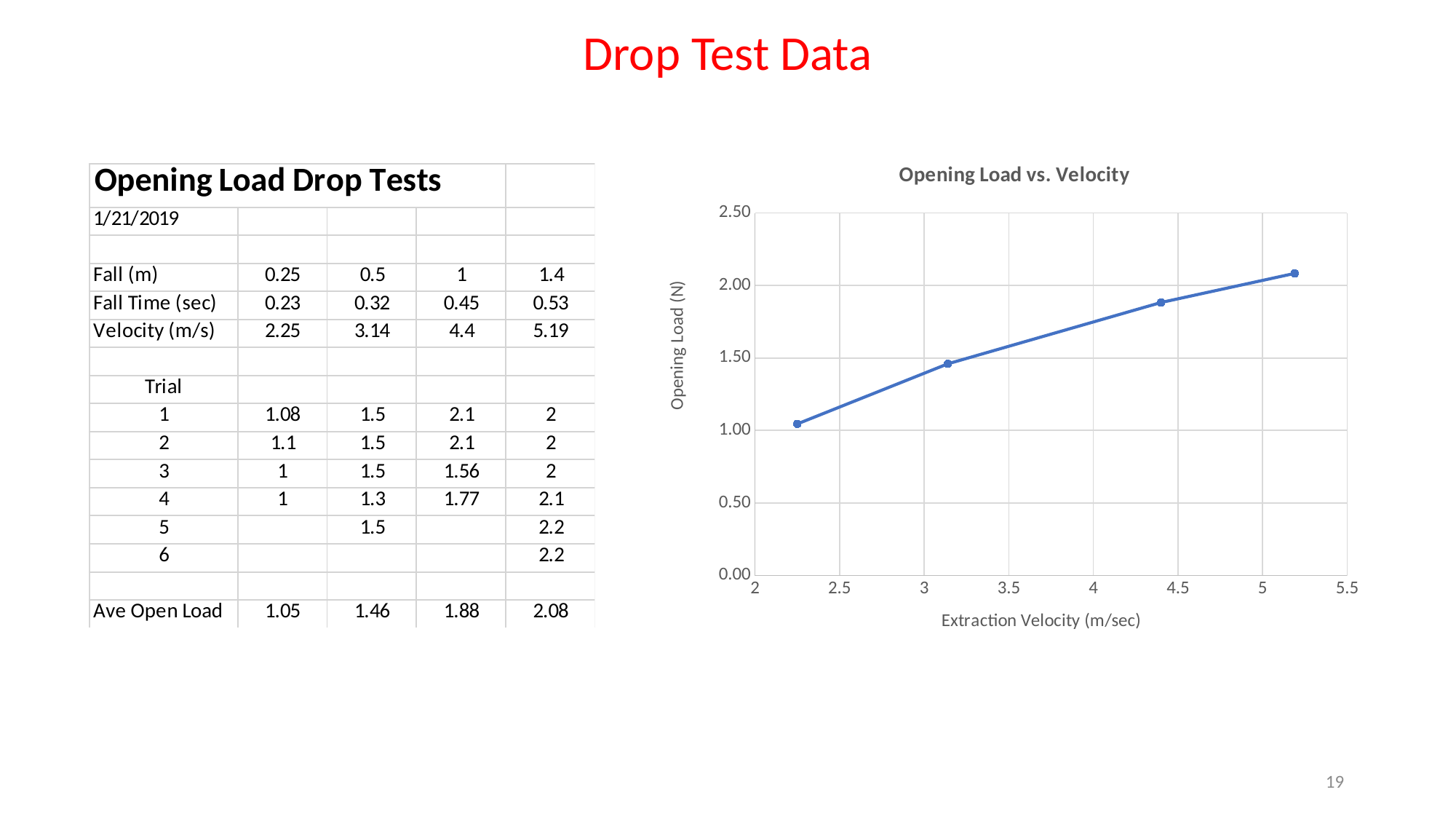
What is the title of the chart on the slide? Opening Load vs. Velocity On the "Opening Load vs. Velocity" chart, is the opening load at the lowest plotted velocity greater or less than 1.50? less What is the label on the vertical axis of the "Opening Load vs. Velocity" chart? Opening Load (N) On the "Opening Load vs. Velocity" chart, is the opening load at the third point from the left greater or less than 1.50? greater On the "Opening Load vs. Velocity" chart, is the opening load at the lowest velocity larger or smaller than at the highest velocity? smaller On the "Opening Load vs. Velocity" chart, does the opening load rise or fall as extraction velocity increases? rises How many data points are plotted on the "Opening Load vs. Velocity" chart? 4 What kind of chart is "Opening Load vs. Velocity"? line chart On the "Opening Load vs. Velocity" chart, is the opening load at the highest plotted velocity greater or less than 1.50? greater On the "Opening Load vs. Velocity" chart, which point has the highest opening load: the one at the lowest velocity or the one at the highest velocity? the one at the highest velocity